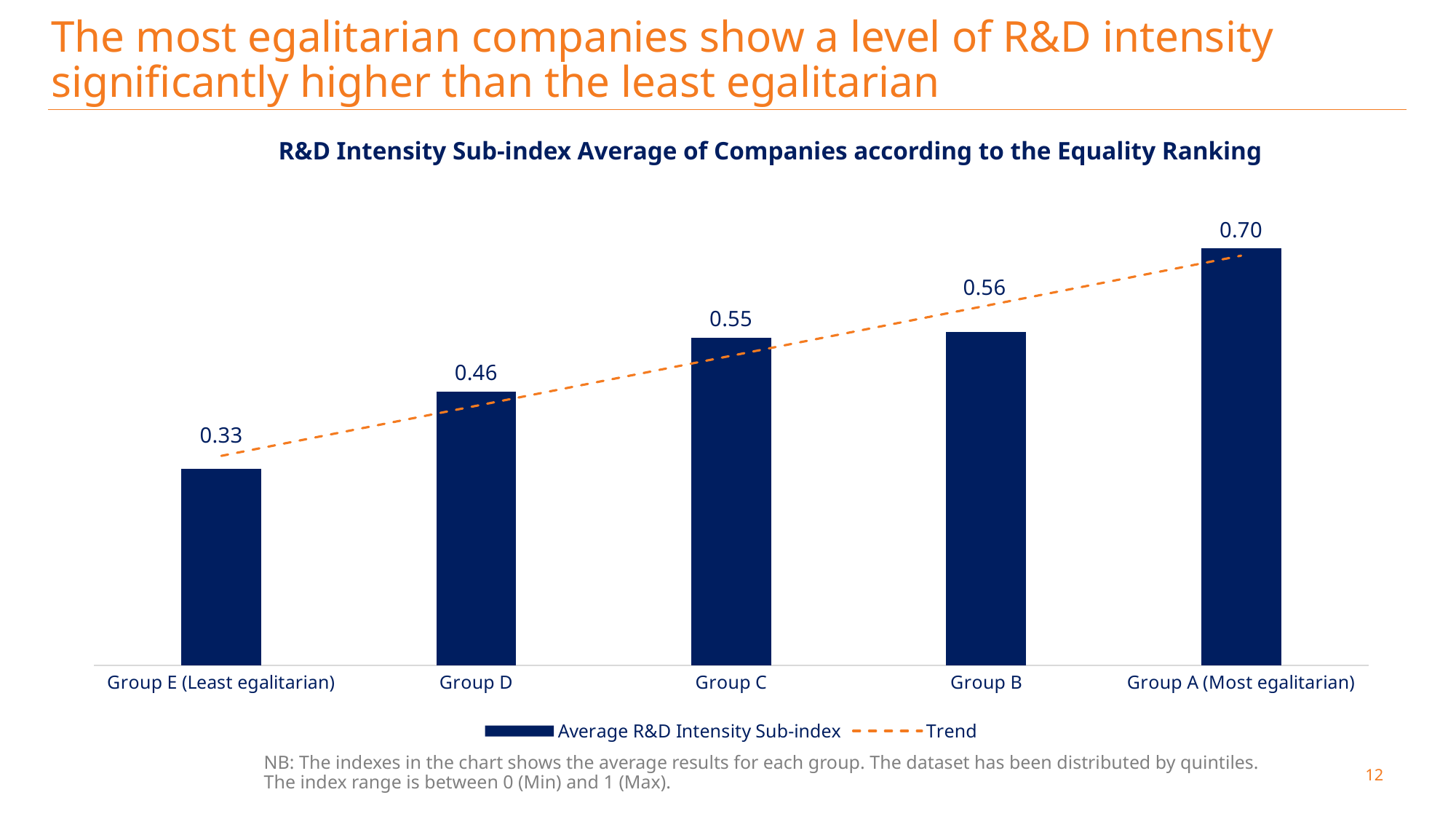
What is the Average R&D Intensity Sub-index value for Group E (Least egalitarian)? 0.33 What is the difference between the Average R&D Intensity Sub-index of Group A (Most egalitarian) and Group E (Least egalitarian)? 0.37 What is the Average R&D Intensity Sub-index value for Group C? 0.55 Which has a higher Average R&D Intensity Sub-index, Group D or Group B? Group B What is the Average R&D Intensity Sub-index value for Group A (Most egalitarian)? 0.70 Which group has the highest Average R&D Intensity Sub-index? Group A (Most egalitarian) How many series does the chart legend list? 2 What is the difference between the Average R&D Intensity Sub-index of Group D and Group C? 0.09 Do the Average R&D Intensity Sub-index values rise or fall from Group E to Group A along the x axis? Rise Which group has the lowest Average R&D Intensity Sub-index? Group E (Least egalitarian) What kind of chart is used to show the Average R&D Intensity Sub-index? Bar chart How many groups are shown on the x axis of the chart? 5